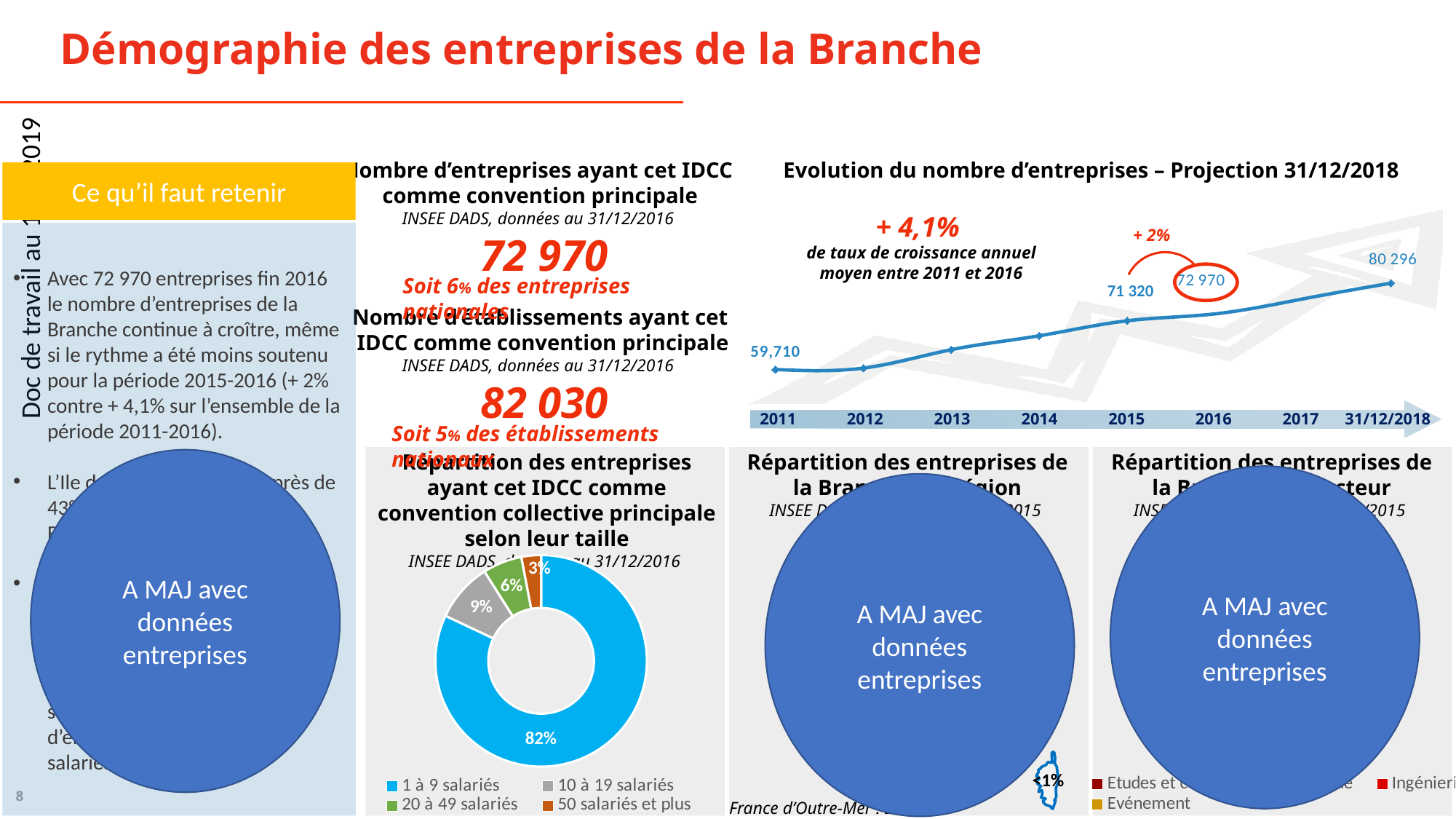
In the chart 'Evolution du nombre d'entreprises – Projection 31/12/2018', what is the value for 2016? 72 970 In the chart 'Evolution du nombre d'entreprises – Projection 31/12/2018', what is the value for 2015? 71 320 In the donut chart 'Répartition des entreprises ayant cet IDCC comme convention collective principale selon leur taille', which is larger: '10 à 19 salariés' or '20 à 49 salariés'? 10 à 19 salariés In the chart 'Evolution du nombre d'entreprises – Projection 31/12/2018', what is the value for 2011? 59,710 In the donut chart 'Répartition des entreprises ayant cet IDCC comme convention collective principale selon leur taille', how many categories does the legend list? 4 In the chart 'Evolution du nombre d'entreprises – Projection 31/12/2018', what is the difference between the 2016 value and the 2015 value? 1 650 In the donut chart 'Répartition des entreprises ayant cet IDCC comme convention collective principale selon leur taille', which category has the smallest share? 50 salariés et plus In the donut chart 'Répartition des entreprises ayant cet IDCC comme convention collective principale selon leur taille', what share is '1 à 9 salariés'? 82% In the chart 'Evolution du nombre d'entreprises – Projection 31/12/2018', how many points are plotted along the x axis? 8 In the chart 'Evolution du nombre d'entreprises – Projection 31/12/2018', what kind of chart is shown? line chart In the chart 'Evolution du nombre d'entreprises – Projection 31/12/2018', what is the projected value for 31/12/2018? 80 296 In the chart 'Evolution du nombre d'entreprises – Projection 31/12/2018', do the values rise or fall from 2011 to 31/12/2018? rise